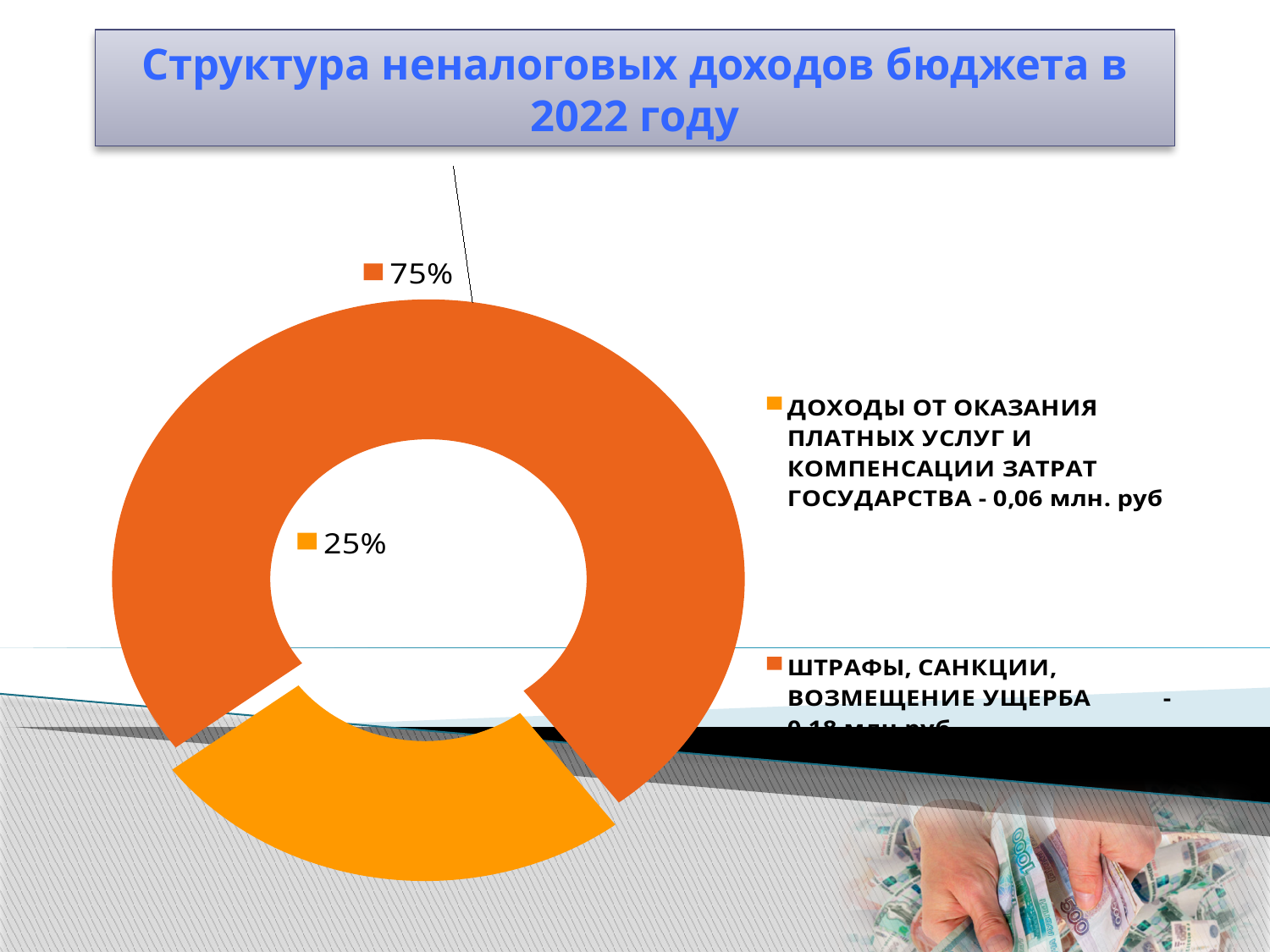
What kind of chart is shown on the slide? Doughnut (pie) chart What share of the doughnut chart is taken by ШТРАФЫ, САНКЦИИ, ВОЗМЕЩЕНИЕ УЩЕРБА? 75% What share of the doughnut chart is taken by ДОХОДЫ ОТ ОКАЗАНИЯ ПЛАТНЫХ УСЛУГ И КОМПЕНСАЦИИ ЗАТРАТ ГОСУДАРСТВА? 25% Which is larger: the share for ШТРАФЫ, САНКЦИИ, ВОЗМЕЩЕНИЕ УЩЕРБА or the share for ДОХОДЫ ОТ ОКАЗАНИЯ ПЛАТНЫХ УСЛУГ И КОМПЕНСАЦИИ ЗАТРАТ ГОСУДАРСТВА? ШТРАФЫ, САНКЦИИ, ВОЗМЕЩЕНИЕ УЩЕРБА By how many percentage points does the 75% slice exceed the 25% slice? 50 percentage points How many slices does the doughnut chart have? 2 Which category has the largest share of the doughnut chart? ШТРАФЫ, САНКЦИИ, ВОЗМЕЩЕНИЕ УЩЕРБА Which category has the smallest share of the doughnut chart? ДОХОДЫ ОТ ОКАЗАНИЯ ПЛАТНЫХ УСЛУГ И КОМПЕНСАЦИИ ЗАТРАТ ГОСУДАРСТВА What is the title of the chart on the slide? Структура неналоговых доходов бюджета в 2022 году What amount in млн. руб is given in the legend for ДОХОДЫ ОТ ОКАЗАНИЯ ПЛАТНЫХ УСЛУГ И КОМПЕНСАЦИИ ЗАТРАТ ГОСУДАРСТВА? 0,06 млн. руб What colour is the slice labelled 25%? Yellow-orange (light orange)